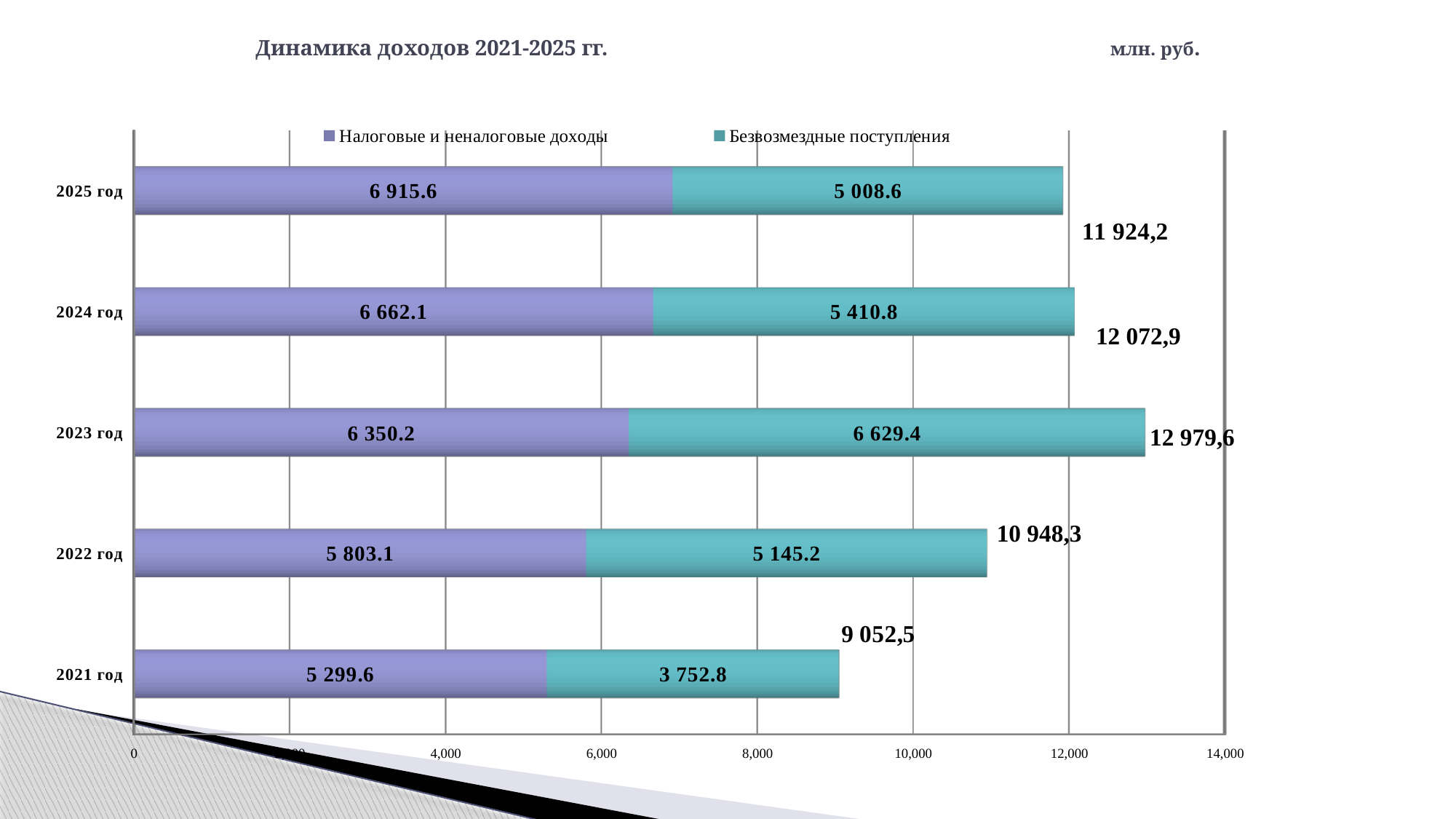
What is the value of Безвозмездные поступления for 2023 год? 6 629.4 What type of chart is shown on the slide? Stacked bar chart What is the total shown for the 2024 год bar? 12 072,9 How many years are shown in the chart? 5 What is the value of Безвозмездные поступления for 2021 год? 3 752.8 What is the value of Налоговые и неналоговые доходы for 2025 год? 6 915.6 What is the difference between Налоговые и неналоговые доходы in 2025 год and 2024 год? 253.5 Which year has the lowest value of Безвозмездные поступления? 2021 год Which is larger in 2023 год: Налоговые и неналоговые доходы or Безвозмездные поступления? Безвозмездные поступления Which year has the largest total income? 2023 год How many series does the legend list? 2 Which year has the highest value of Налоговые и неналоговые доходы? 2025 год